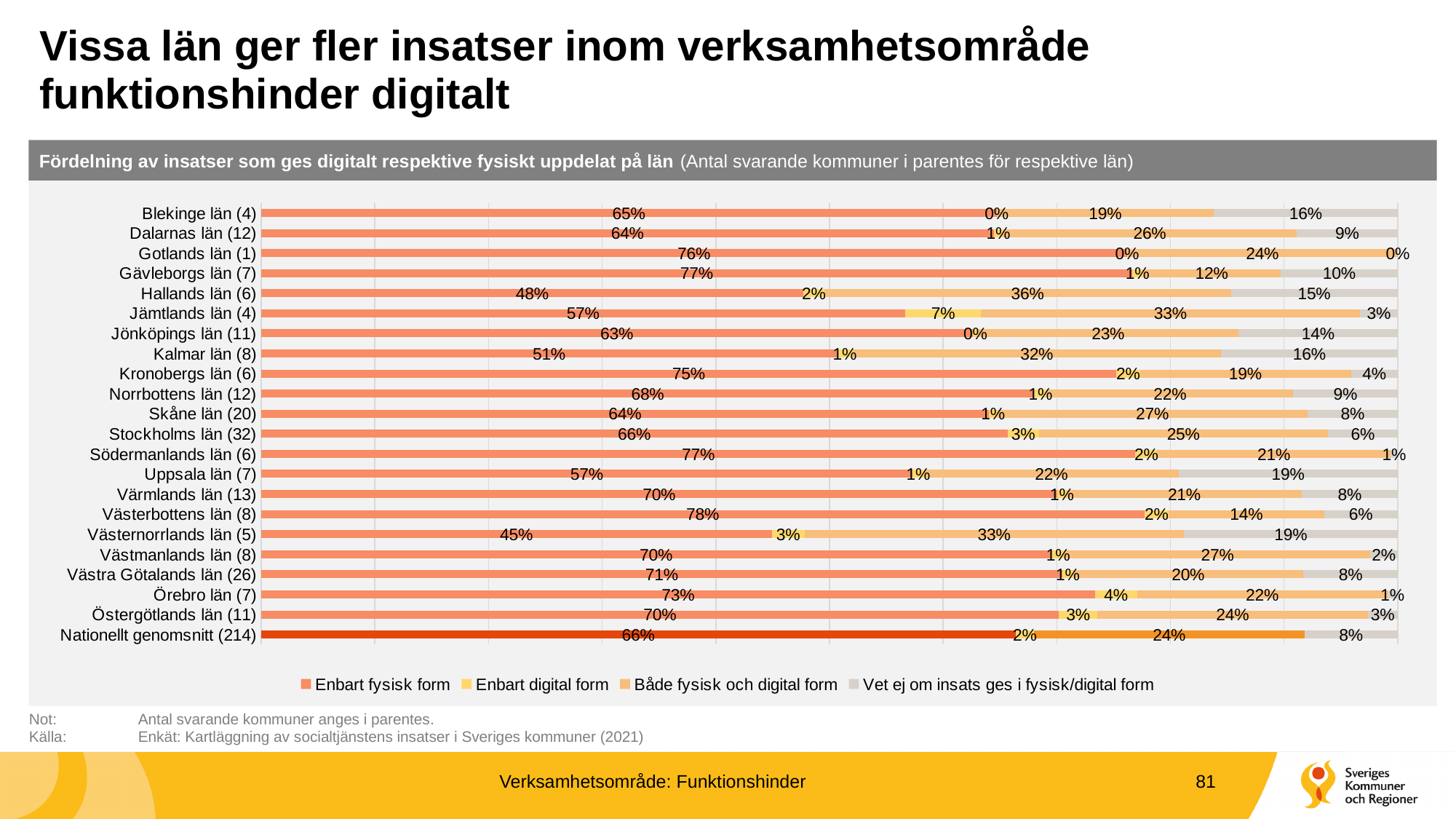
What is the title of the chart? Fördelning av insatser som ges digitalt respektive fysiskt uppdelat på län What type of chart is shown on the slide? Stacked bar chart How many series does the legend list? 4 Which category has the highest value for 'Enbart digital form'? Jämtlands län (4) Which has a larger 'Både fysisk och digital form' value, Hallands län (6) or Stockholms län (32)? Hallands län (6) What is the value for 'Vet ej om insats ges i fysisk/digital form' for Uppsala län (7)? 19% How many bars (categories) are plotted in the chart? 22 What is the value for 'Enbart fysisk form' for Hallands län (6)? 48% What is the difference between the 'Enbart fysisk form' values for Gävleborgs län (7) and Kalmar län (8)? 26% What is the value for 'Både fysisk och digital form' for Nationellt genomsnitt (214)? 24% Which category has the lowest value for 'Enbart fysisk form'? Västernorrlands län (5) Which category has the highest value for 'Enbart fysisk form'? Västerbottens län (8)